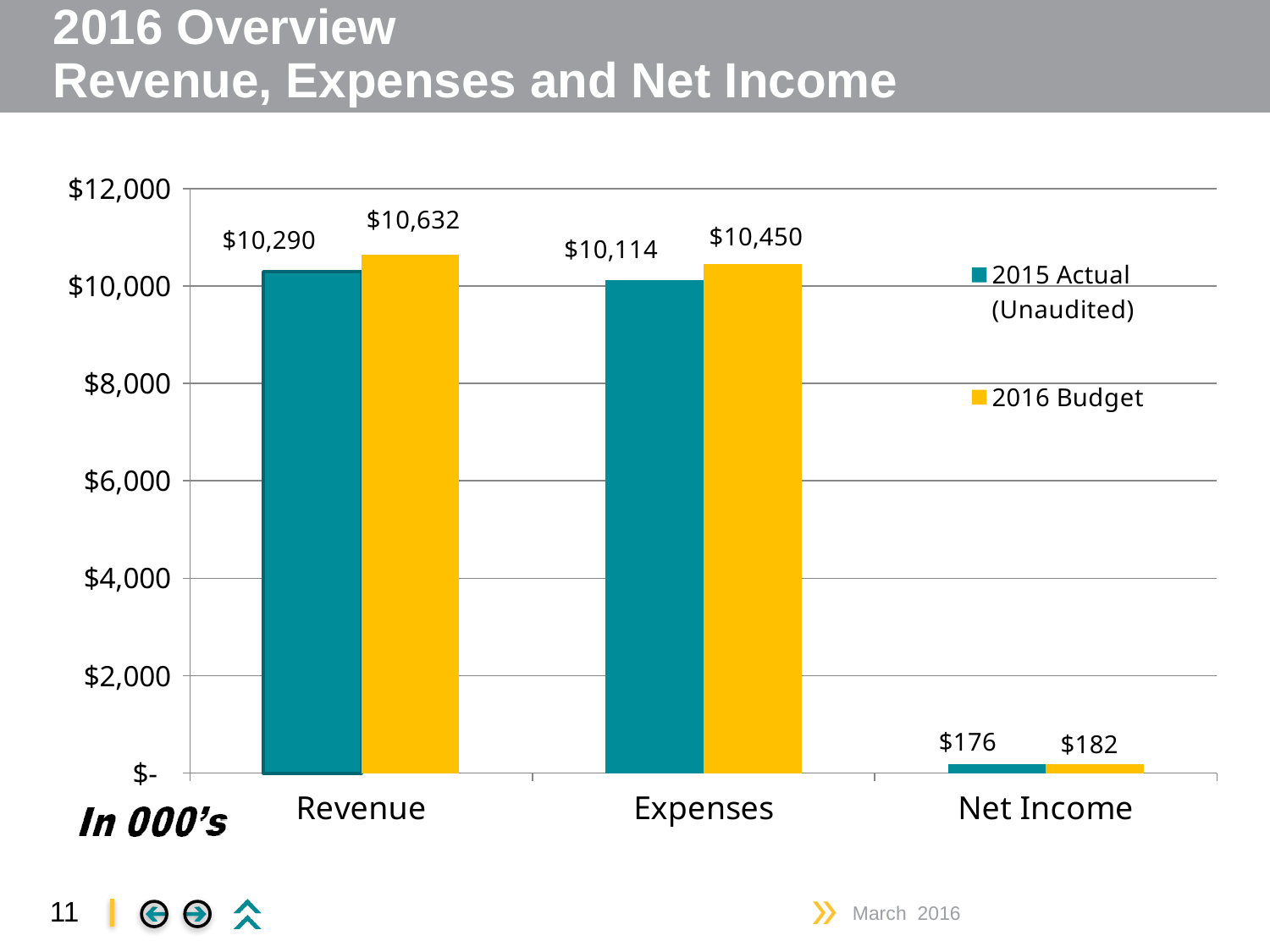
What is the 2015 Actual (Unaudited) value for Net Income? $176 How many series does the legend list? 2 What is the 2016 Budget value for Revenue? $10,632 What is the 2015 Actual (Unaudited) value for Expenses? $10,114 What is the difference between the 2016 Budget values for Revenue and Expenses? $182 Which is larger for Expenses: the 2015 Actual (Unaudited) value or the 2016 Budget value? 2016 Budget How many categories are shown on the x axis? 3 What kind of chart is shown on the slide? Bar chart What is the difference between the 2016 Budget and 2015 Actual (Unaudited) values for Revenue? $342 Which category has the highest 2015 Actual (Unaudited) value? Revenue Which category has the lowest 2016 Budget value? Net Income What is the 2016 Budget value for Net Income? $182